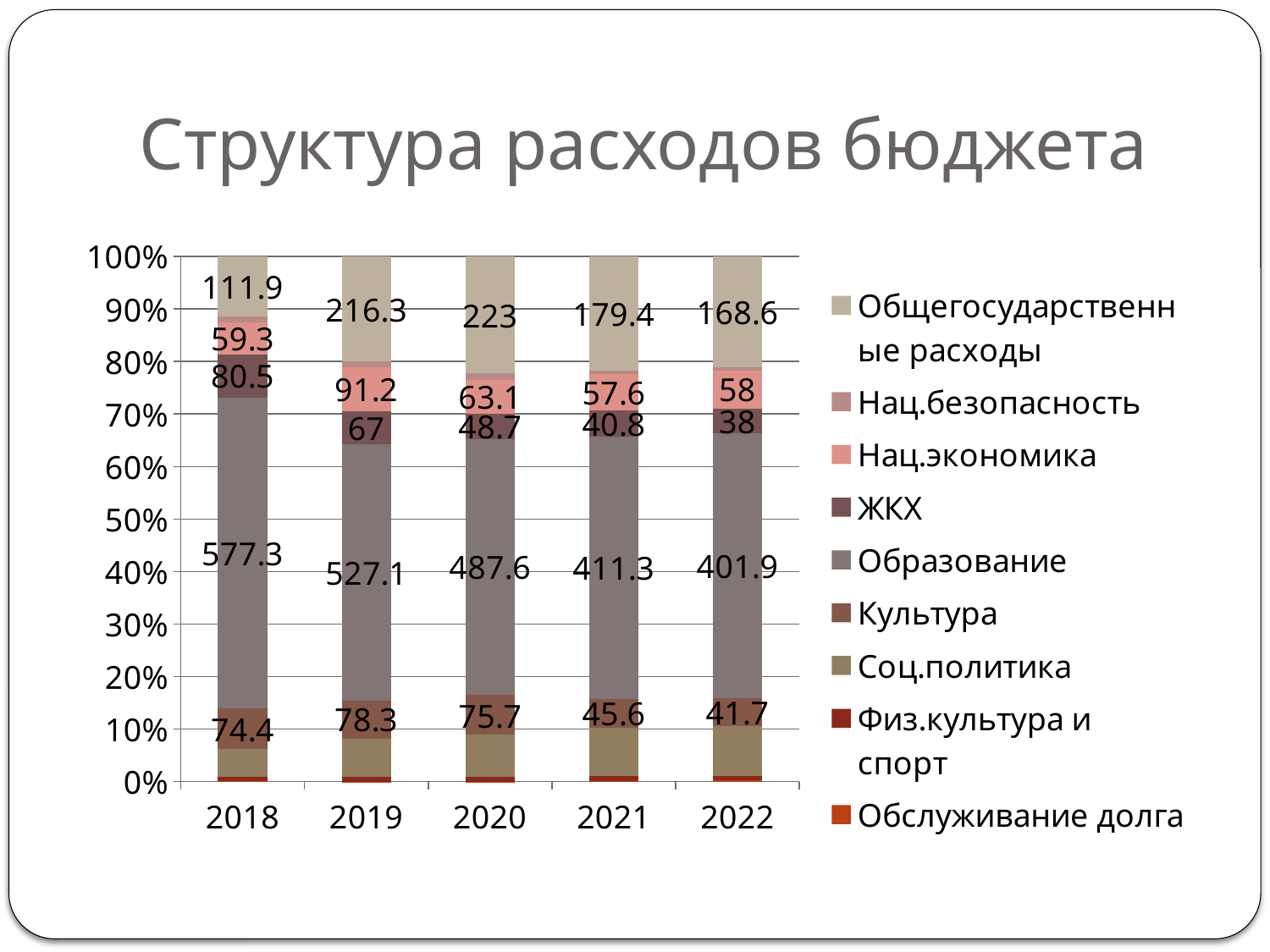
What is the value for ЖКХ in 2022? 38 What is the value for Образование in 2018? 577.3 How many series does the legend list? 9 What is the value for Общегосударственные расходы in 2020? 223 What is the difference between the Образование values for 2018 and 2022? 175.4 How many years are shown on the x axis of the chart? 5 In which year is the value for Образование the highest? 2018 Which year has the larger value for Нац.экономика, 2019 or 2020? 2019 Do the values for Образование rise or fall from 2018 to 2022? Fall What kind of chart is shown on the slide? Stacked bar chart What is the value for Нац.экономика in 2019? 91.2 In which year is the value for Общегосударственные расходы the lowest? 2018